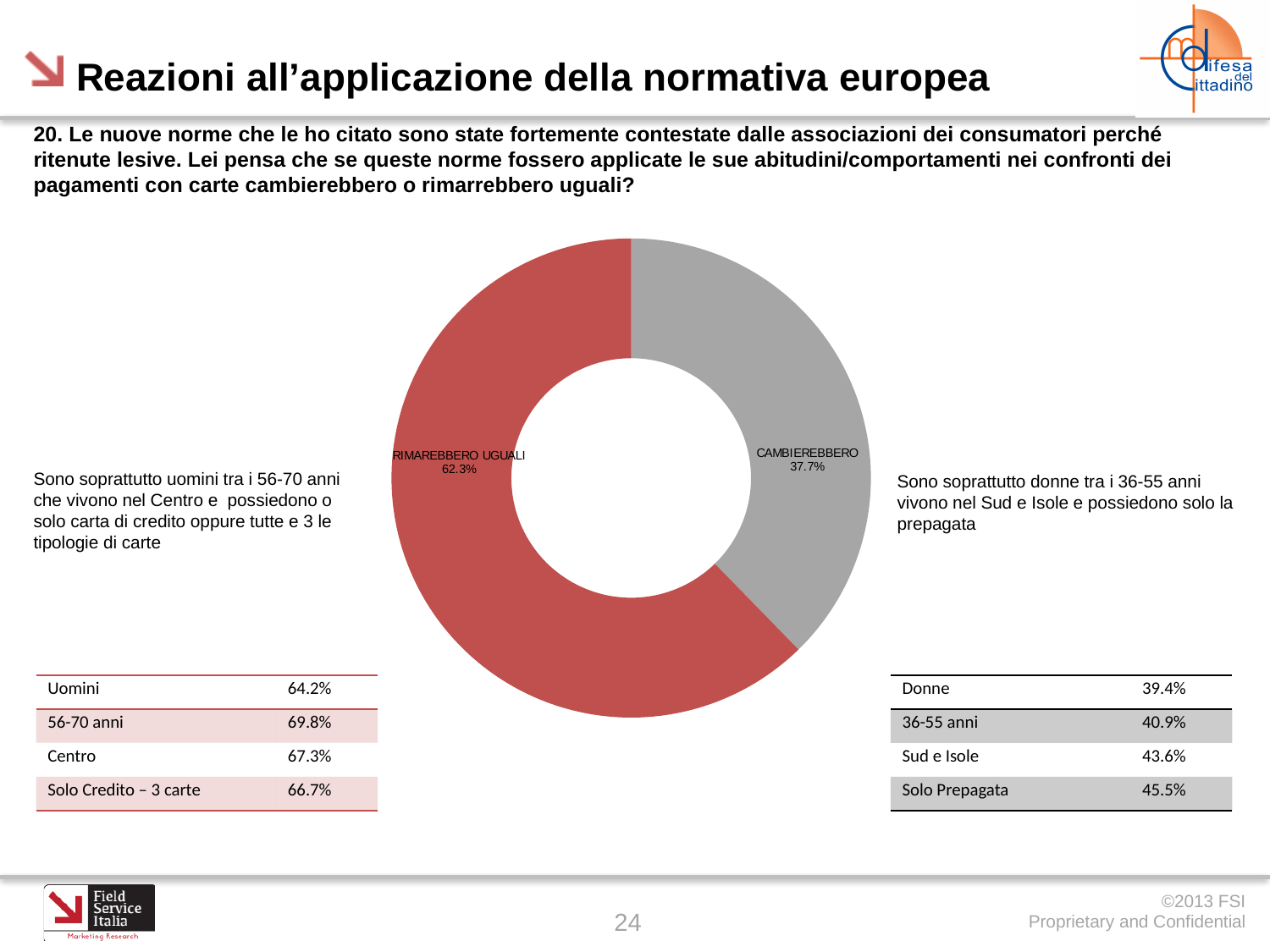
Is the share for CAMBIEREBBERO greater or less than 50%? less Which is larger, the share for RIMAREBBERO UGUALI or the share for CAMBIEREBBERO? RIMAREBBERO UGUALI Which colour represents the CAMBIEREBBERO segment? Grey Is the share for RIMAREBBERO UGUALI greater or less than 50%? greater What kind of chart is shown on the slide? Doughnut (pie) chart Which colour represents the RIMAREBBERO UGUALI segment? Red Which response has the larger share of the chart? RIMAREBBERO UGUALI What percentage of respondents answered RIMAREBBERO UGUALI? 62.3% How many categories are shown in the chart? 2 What percentage of respondents answered CAMBIEREBBERO? 37.7% Which response has the smaller share of the chart? CAMBIEREBBERO What is the difference in percentage points between RIMAREBBERO UGUALI and CAMBIEREBBERO? 24.6